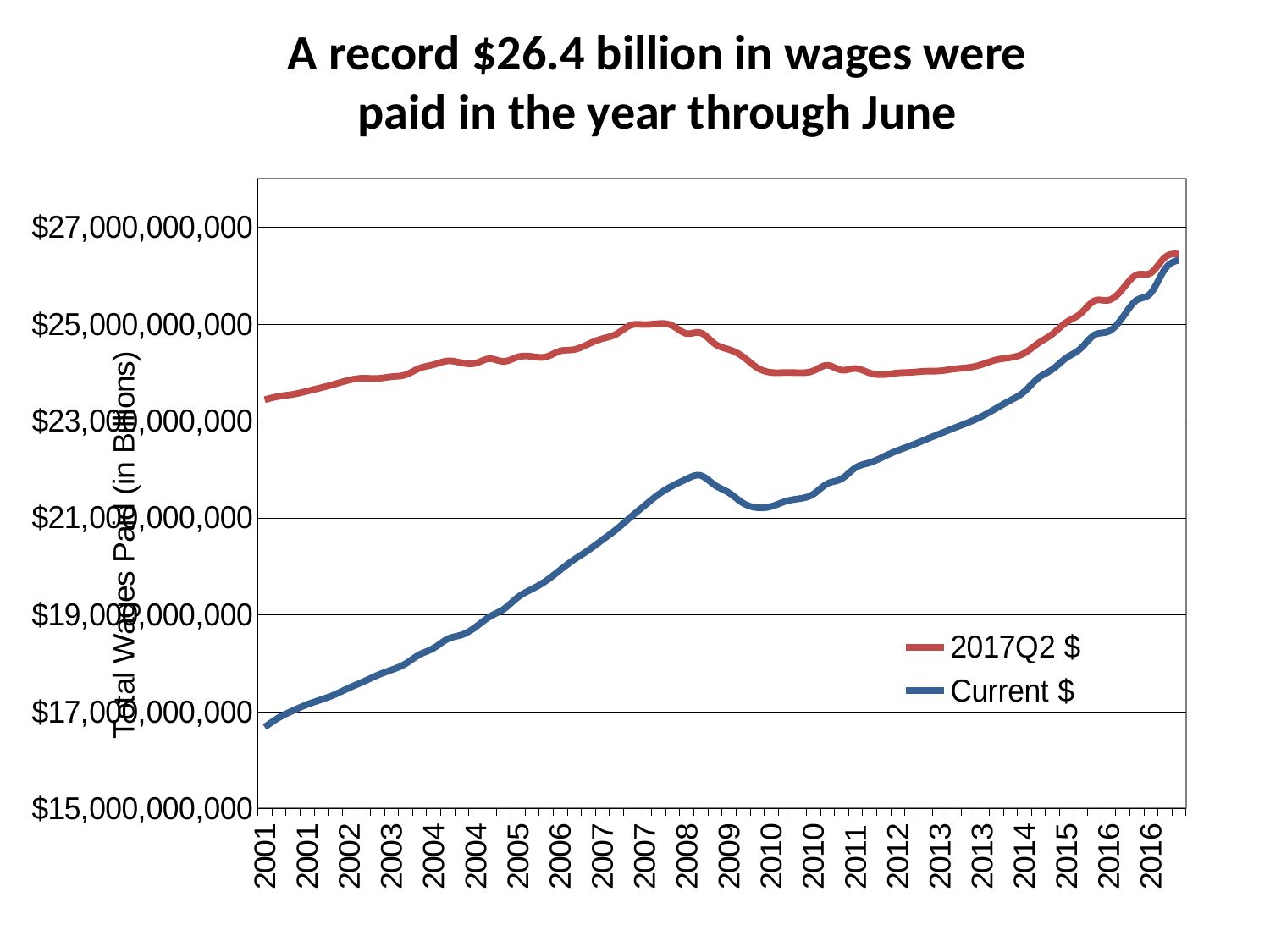
What are the two series named in the legend? 2017Q2 $ and Current $ Does the 2017Q2 $ series rise or fall between 2007 and 2010? fall Is the value of the 2017Q2 $ series in 2010 greater or less than $25,000,000,000? less Is the value of the 2017Q2 $ series at the start of 2001 greater or less than $23,000,000,000? greater What is the label on the vertical axis? Total Wages Paid (in Billions) Is the value of the Current $ series in 2010 greater or less than $23,000,000,000? less Does the Current $ series generally rise or fall from 2001 to 2016? rise Which series has the higher value in 2005, 2017Q2 $ or Current $? 2017Q2 $ How many series does the legend list? 2 What kind of chart is shown on the slide? line chart